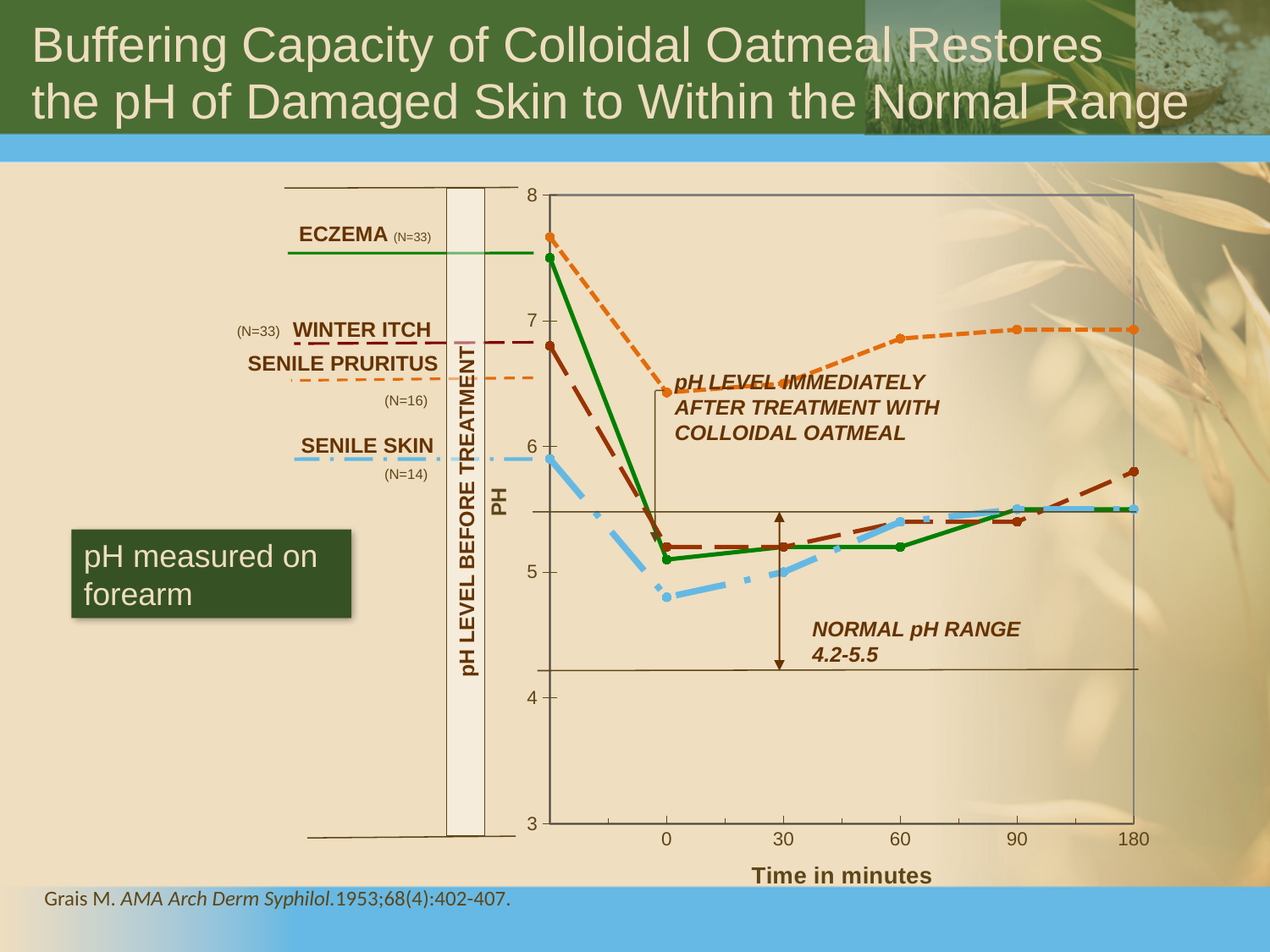
How many skin conditions (series) are plotted on the chart? 4 Is the pH value for Eczema at 60 minutes greater or less than 6? less Is the pH value for Eczema before treatment greater or less than 7? greater Before treatment, which has the higher pH: Eczema or Senile Skin? Eczema Is the pH value for Senile Skin at 0 minutes (immediately after treatment) greater or less than 5? less Which series has the lowest pH at 0 minutes (immediately after treatment)? Senile Skin What is the normal pH range stated on the chart? 4.2-5.5 How many labeled time points are shown on the x axis? 5 What kind of chart is shown on the slide? line chart Which series has the highest pH at 180 minutes? Senile Pruritus Does the pH for Senile Pruritus rise or fall from 0 to 180 minutes? rise